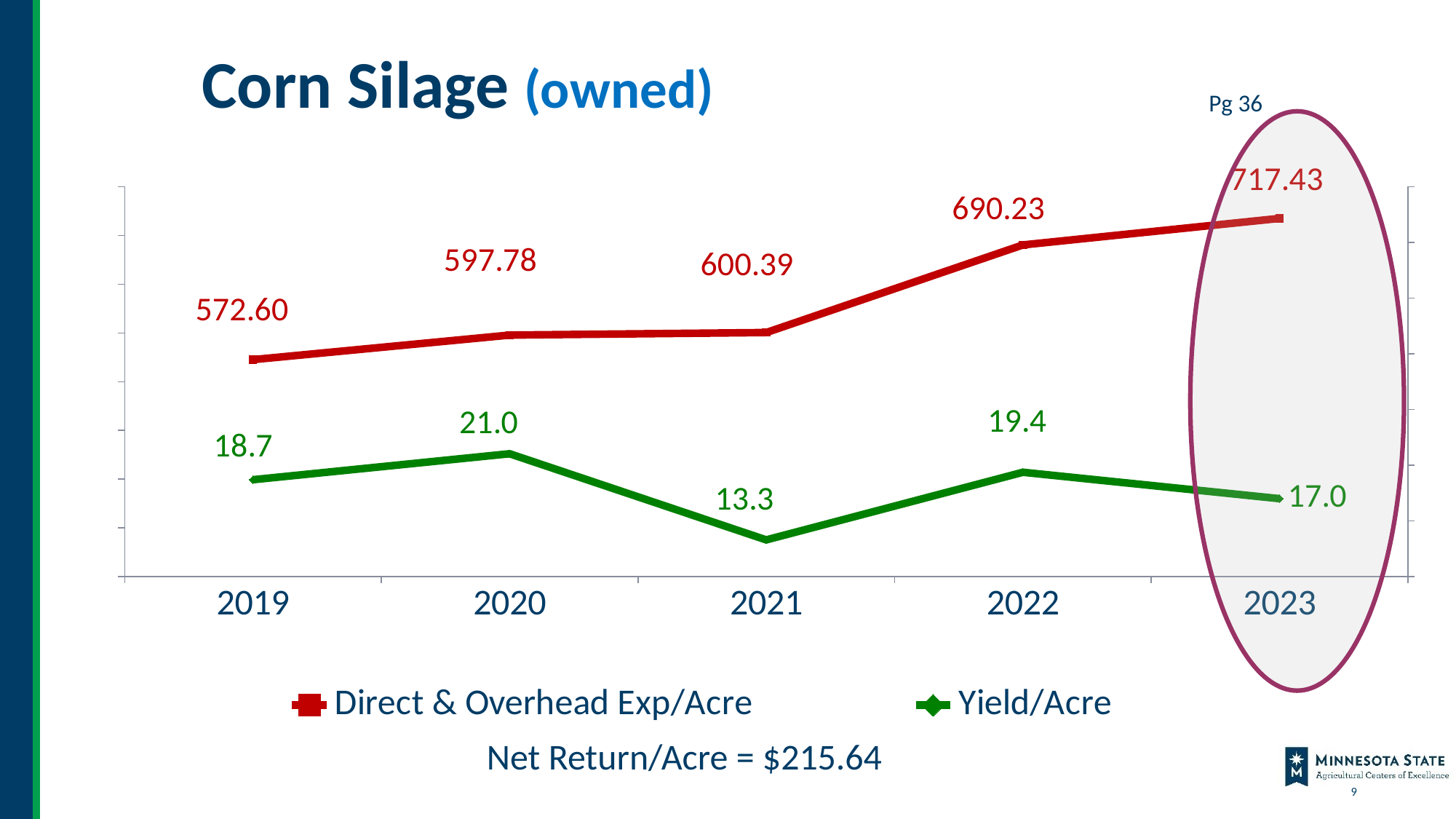
What is the Direct & Overhead Exp/Acre value for 2023? 717.43 What kind of chart is shown on the slide? Line chart What is the difference between the Direct & Overhead Exp/Acre values for 2023 and 2022? 27.20 In which year is Yield/Acre highest? 2020 What is the Yield/Acre value for 2021? 13.3 What is the difference between the Yield/Acre values for 2020 and 2021? 7.7 Which year has the larger Yield/Acre, 2022 or 2023? 2022 How many series does the legend list? 2 How many years are shown on the x axis? 5 What is the Direct & Overhead Exp/Acre value for 2019? 572.60 In which year is Yield/Acre lowest? 2021 In which year is Direct & Overhead Exp/Acre lowest? 2019